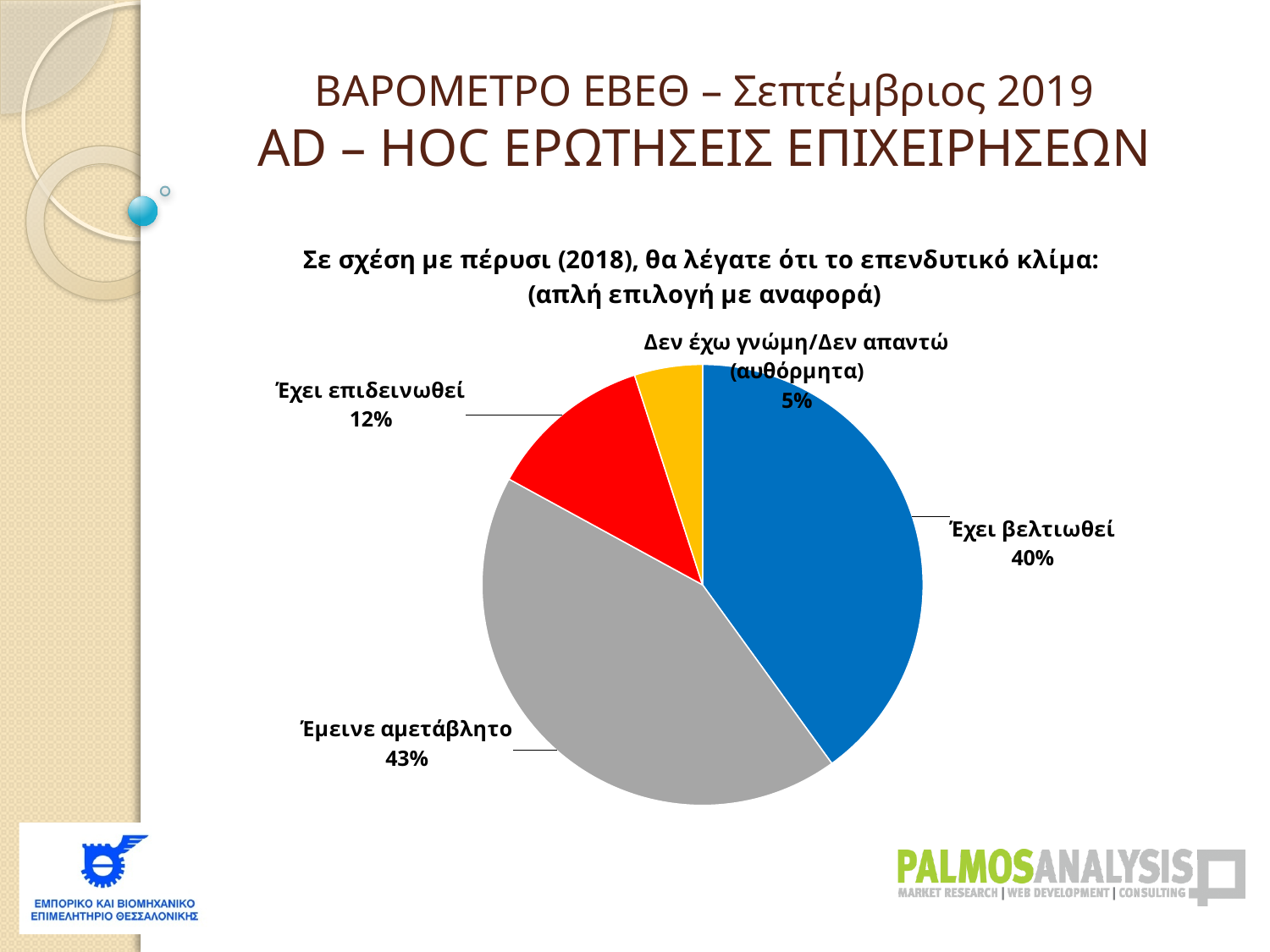
Which category has the largest slice of the pie? Έμεινε αμετάβλητο What kind of chart is shown on the slide? Pie chart What is the value shown for "Δεν έχω γνώμη/Δεν απαντώ (αυθόρμητα)"? 5% Which category has the smallest slice of the pie? Δεν έχω γνώμη/Δεν απαντώ (αυθόρμητα) What colour is the slice for "Έμεινε αμετάβλητο"? Grey What is the difference between the values for "Έχει επιδεινωθεί" and "Δεν έχω γνώμη/Δεν απαντώ (αυθόρμητα)"? 7% What is the difference between the values for "Έμεινε αμετάβλητο" and "Έχει βελτιωθεί"? 3% How many categories are shown in the pie chart? 4 Which is larger, the value for "Έχει βελτιωθεί" or the value for "Έχει επιδεινωθεί"? Έχει βελτιωθεί What is the value shown for "Έχει επιδεινωθεί"? 12% What share of the pie does "Έχει βελτιωθεί" represent? 40% What is the value shown for "Έμεινε αμετάβλητο"? 43%